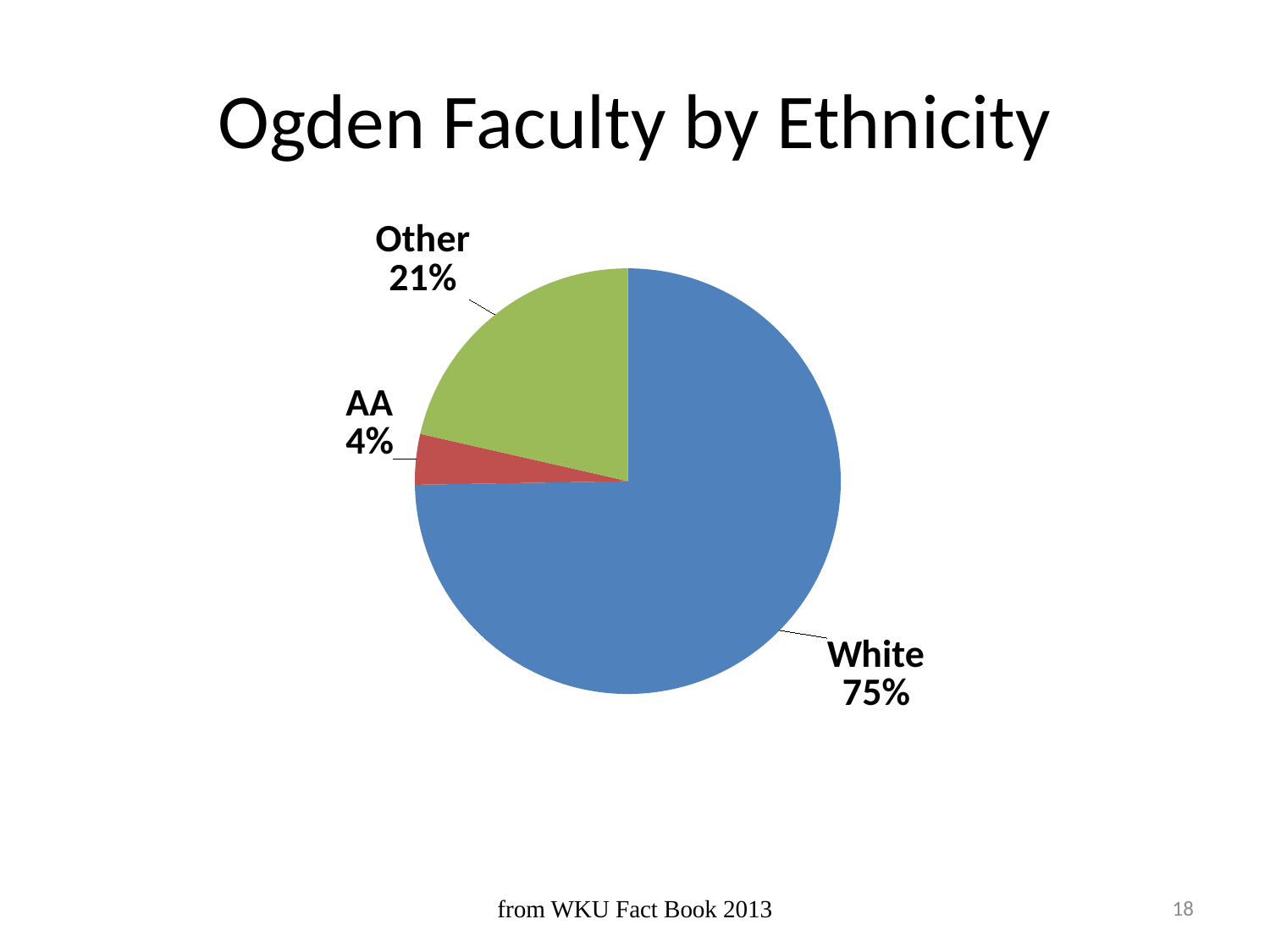
What share of Ogden faculty is White? 75% Which slice is larger, Other or AA? Other What is the title of the chart on the slide? Ogden Faculty by Ethnicity Which ethnicity category has the largest slice of the pie? White How many slices does the pie chart have? 3 What colour is the White slice of the pie? blue What kind of chart is shown on the slide? pie chart What is the difference in percentage points between the White and Other slices? 54 Which ethnicity category has the smallest slice of the pie? AA What is the difference in percentage points between the Other and AA slices? 17 What share of Ogden faculty is Other? 21% What share of Ogden faculty is AA? 4%